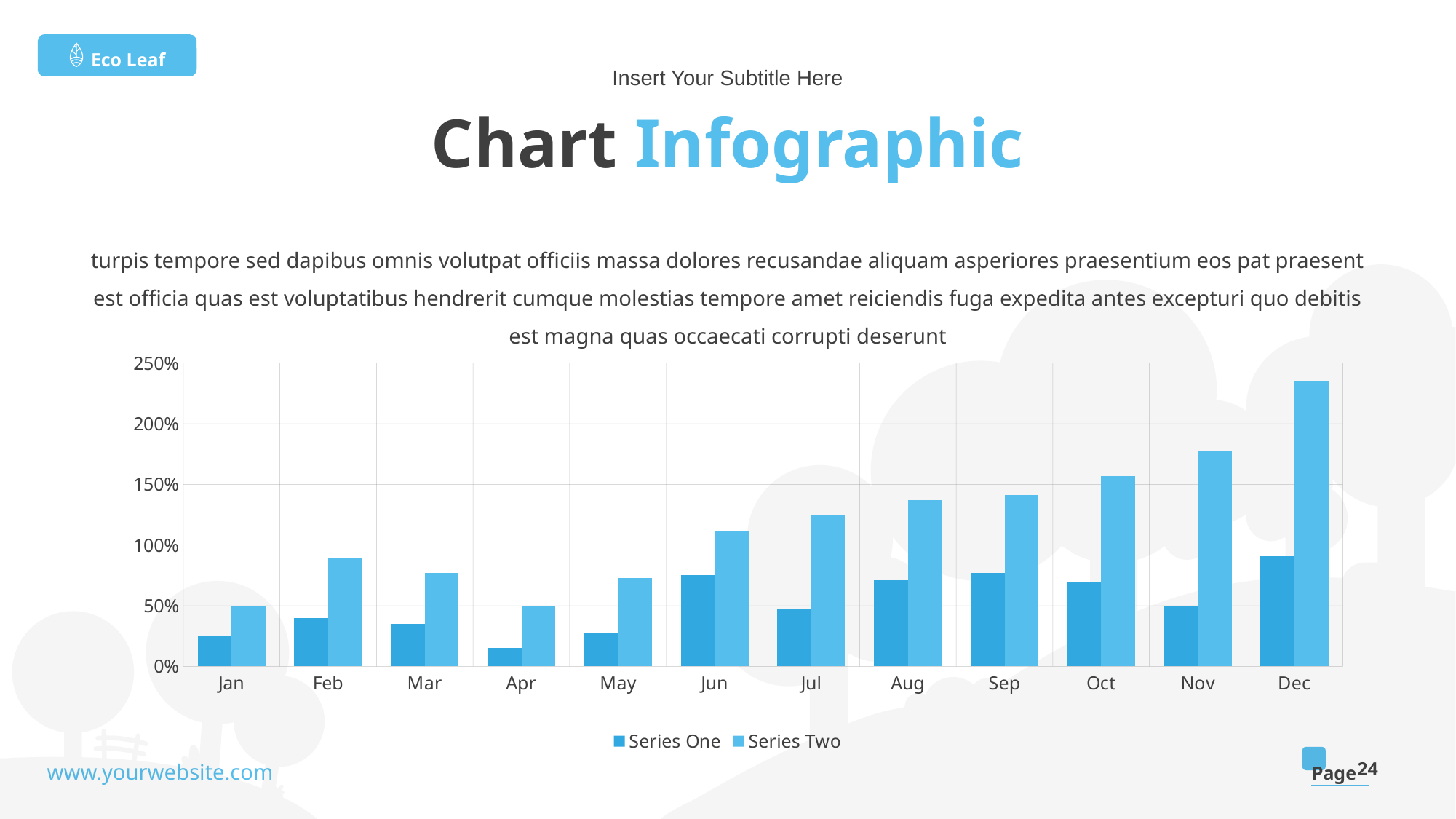
What are the two series names shown in the legend? Series One, Series Two Which month has the lowest Series One value? Apr Is the Series Two value for Oct greater or less than 150%? greater How many series does the legend list? 2 Does the Series Two value generally rise or fall from Jan to Dec? rise How many months are shown on the x axis? 12 Which month has the highest Series One value? Dec Is the Series One value for Jan greater or less than 50%? less Is the Series Two value for Dec greater or less than 200%? greater Which month has the highest Series Two value? Dec What kind of chart is shown on the slide? bar chart Which is larger, the Series One value for Jun or for Jul? Jun